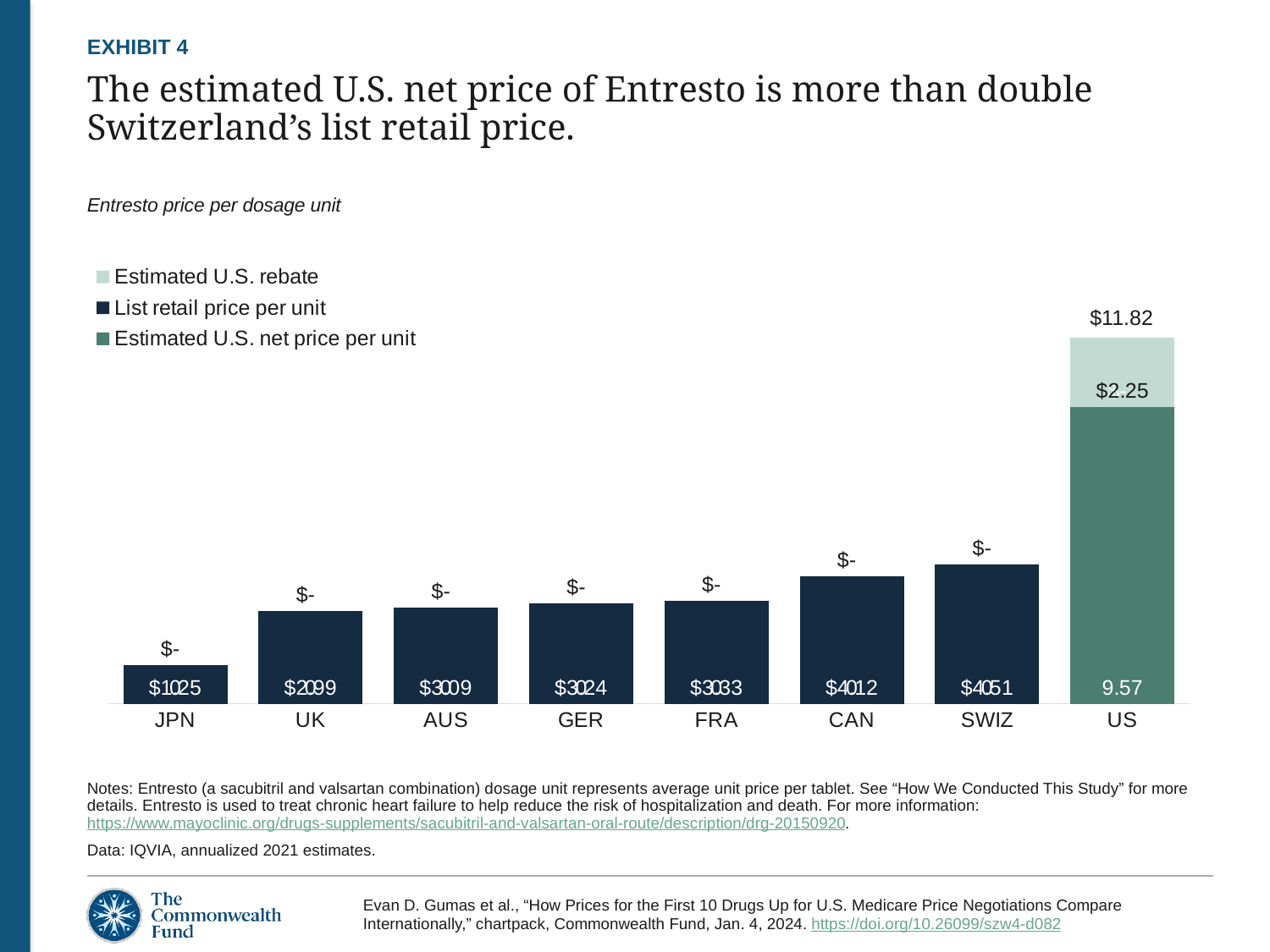
What value is printed at the bottom of the US bar for the estimated U.S. net price per unit? 9.57 How many series does the chart legend list? 3 Is the bar for SWIZ taller or shorter than the bar for JPN? taller Do the bar heights generally rise or fall moving from JPN on the left to US on the right? rise Which country has the tallest bar in the chart? US What kind of chart is shown on the slide? bar chart What is the subtitle printed above the chart legend? Entresto price per dosage unit Which country has the shortest bar in the chart? JPN What value is printed at the top of the US bar? $11.82 Is the bar for CAN taller or shorter than the bar for UK? taller How many countries are shown on the x axis of the chart? 8 What value is printed inside the light green (Estimated U.S. rebate) segment of the US bar? $2.25